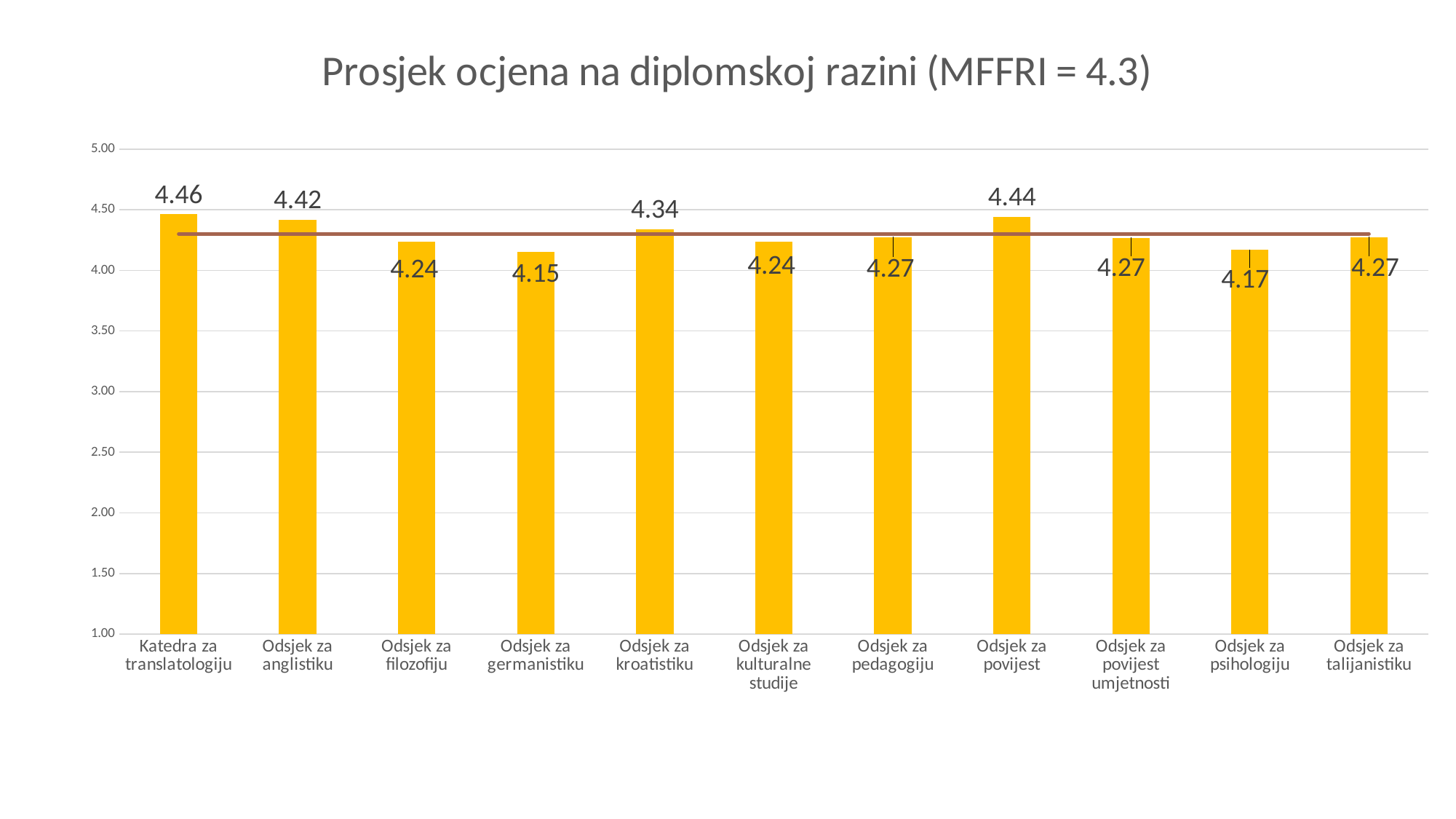
What is the value for Odsjek za germanistiku? 4.15 What is the difference between the values for Odsjek za povijest and Odsjek za kroatistiku? 0.10 What is the difference between the values for Katedra za translatologiju and Odsjek za germanistiku? 0.31 Which category has the lowest value? Odsjek za germanistiku What is the value for Odsjek za kroatistiku? 4.34 What is the value for Odsjek za anglistiku? 4.42 Which is larger, the value for Odsjek za anglistiku or the value for Odsjek za povijest? Odsjek za povijest What kind of chart is this? bar chart What is the value for Odsjek za psihologiju? 4.17 Which category has the highest value? Katedra za translatologiju What is the title of the chart? Prosjek ocjena na diplomskoj razini (MFFRI = 4.3) How many categories are shown on the x axis? 11